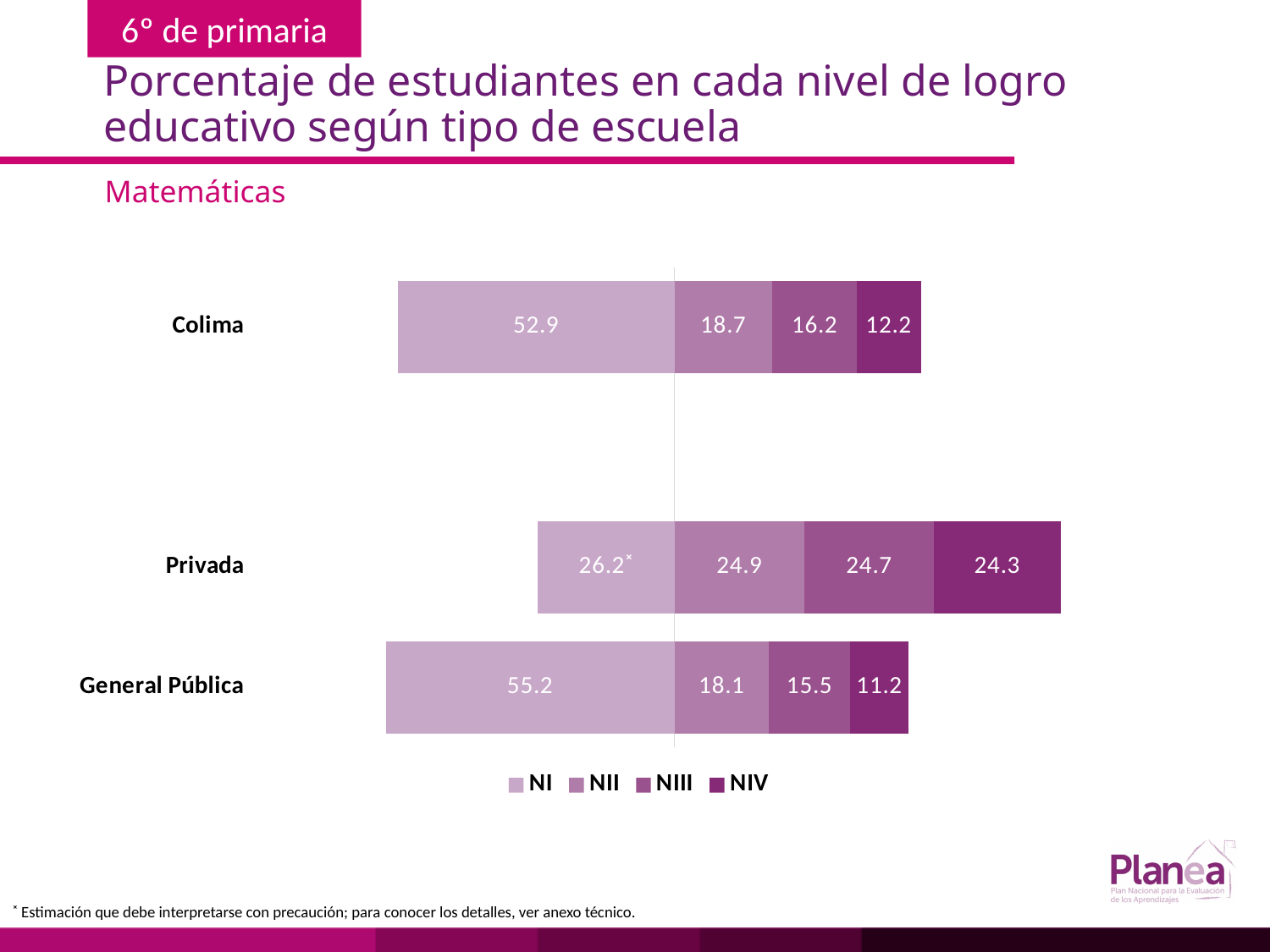
What is the NIV value for Privada? 24.3 What is the NII value for Privada? 24.9 What is the NI value for Colima? 52.9 How many school types (categories) are shown in the chart? 3 What is the difference between the NI values for General Pública and Colima? 2.3 Which school type has the lowest NIV value? General Pública Which school type has the highest NI value? General Pública What is the difference between the NIV values for Privada and Colima? 12.1 How many series does the legend list? 4 What kind of chart is shown on the slide? Stacked bar chart Which is larger, the NII value for Colima or the NII value for General Pública? Colima What is the NIII value for General Pública? 15.5